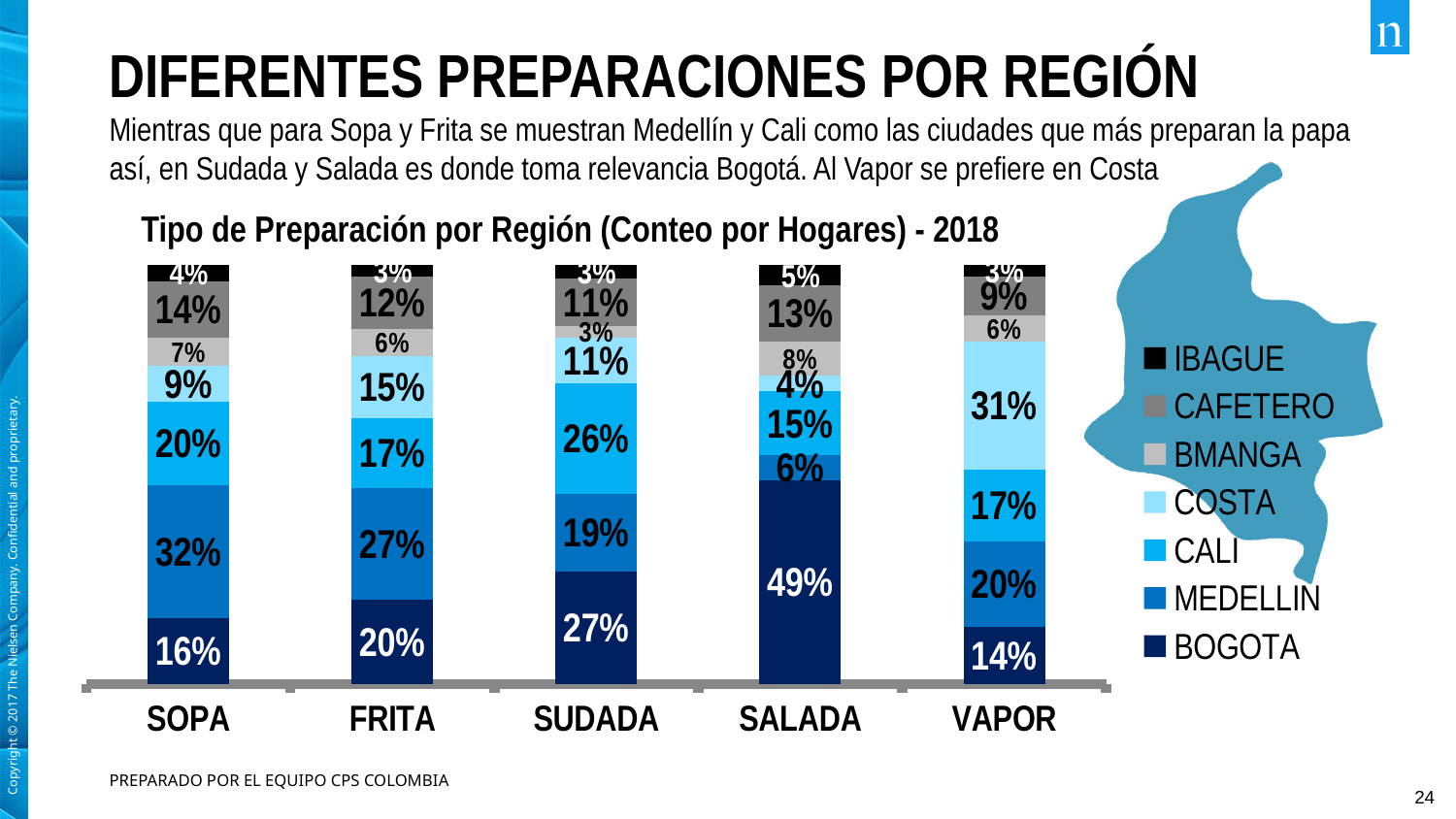
What is the difference between the MEDELLIN values for SOPA and FRITA? 5% What is the MEDELLIN share for SOPA? 32% What kind of chart is shown on the slide? Stacked bar chart What is the title of the chart? Tipo de Preparación por Región (Conteo por Hogares) - 2018 What is the CALI value for SUDADA? 26% Which preparation type has the lowest MEDELLIN share? SALADA Which preparation type has the highest BOGOTA share? SALADA What is the COSTA value for VAPOR? 31% How many regions does the legend list? 7 How many preparation types are shown on the x axis? 5 Which is larger, the CALI value for FRITA or the CALI value for VAPOR? Neither; both are 17% What percentage does BOGOTA account for in the SALADA bar? 49%